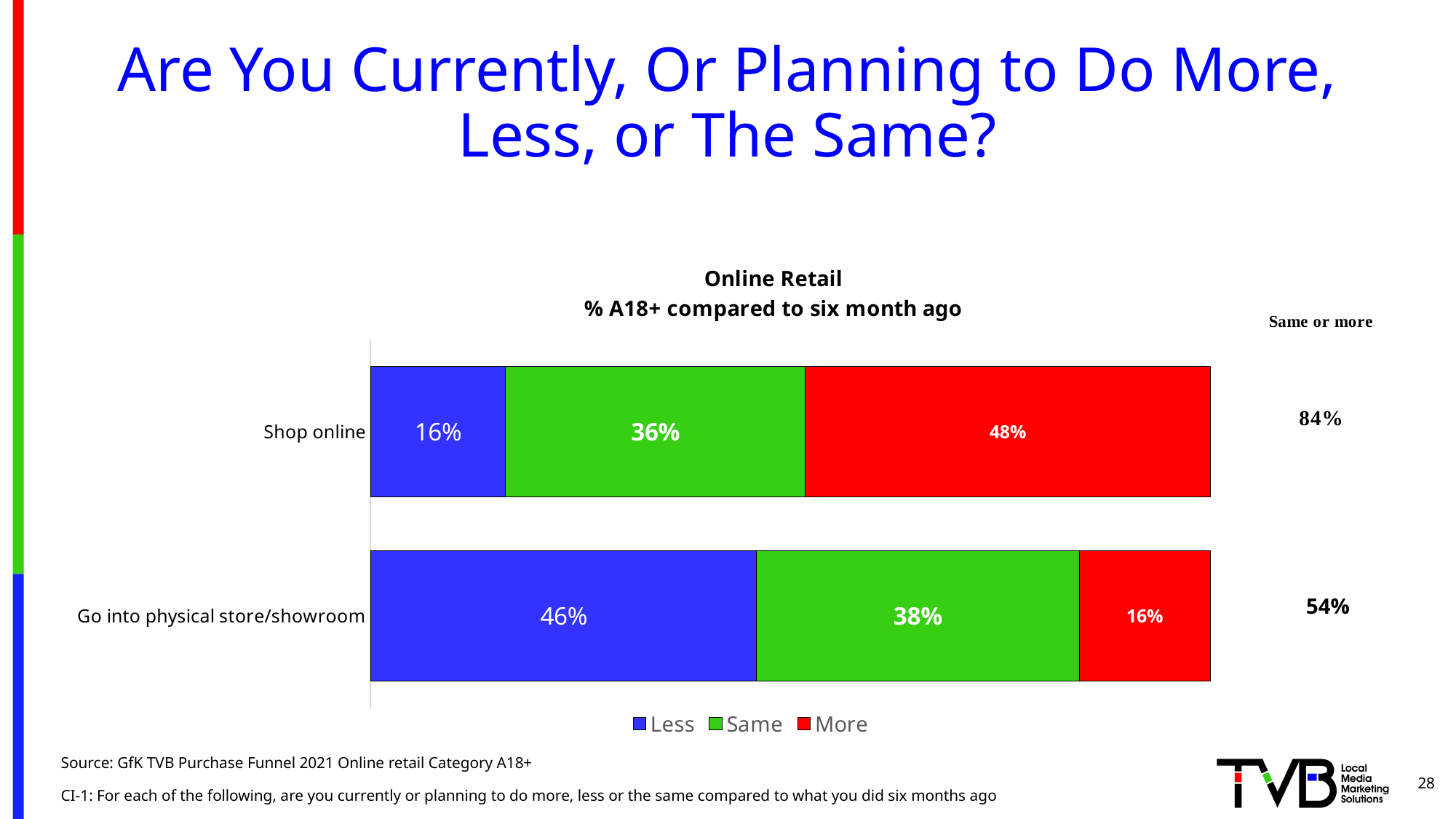
What is the total of the three segments in the Shop online bar? 100% What is the 'Same' value for Shop online? 36% How many series does the legend list? 3 How many categories are shown on the chart? 2 What percentage of respondents say they are doing 'More' shopping online? 48% Which colour represents the 'More' series in the chart? Red What is the 'More' value for Go into physical store/showroom? 16% What is the difference between the 'More' values for Shop online and Go into physical store/showroom? 32% What percentage of respondents say they are doing 'Less' going into a physical store/showroom? 46% Which category has the higher 'Less' value, Shop online or Go into physical store/showroom? Go into physical store/showroom What kind of chart is shown on the slide? Stacked bar chart What is the 'Same or more' figure shown for Shop online? 84%